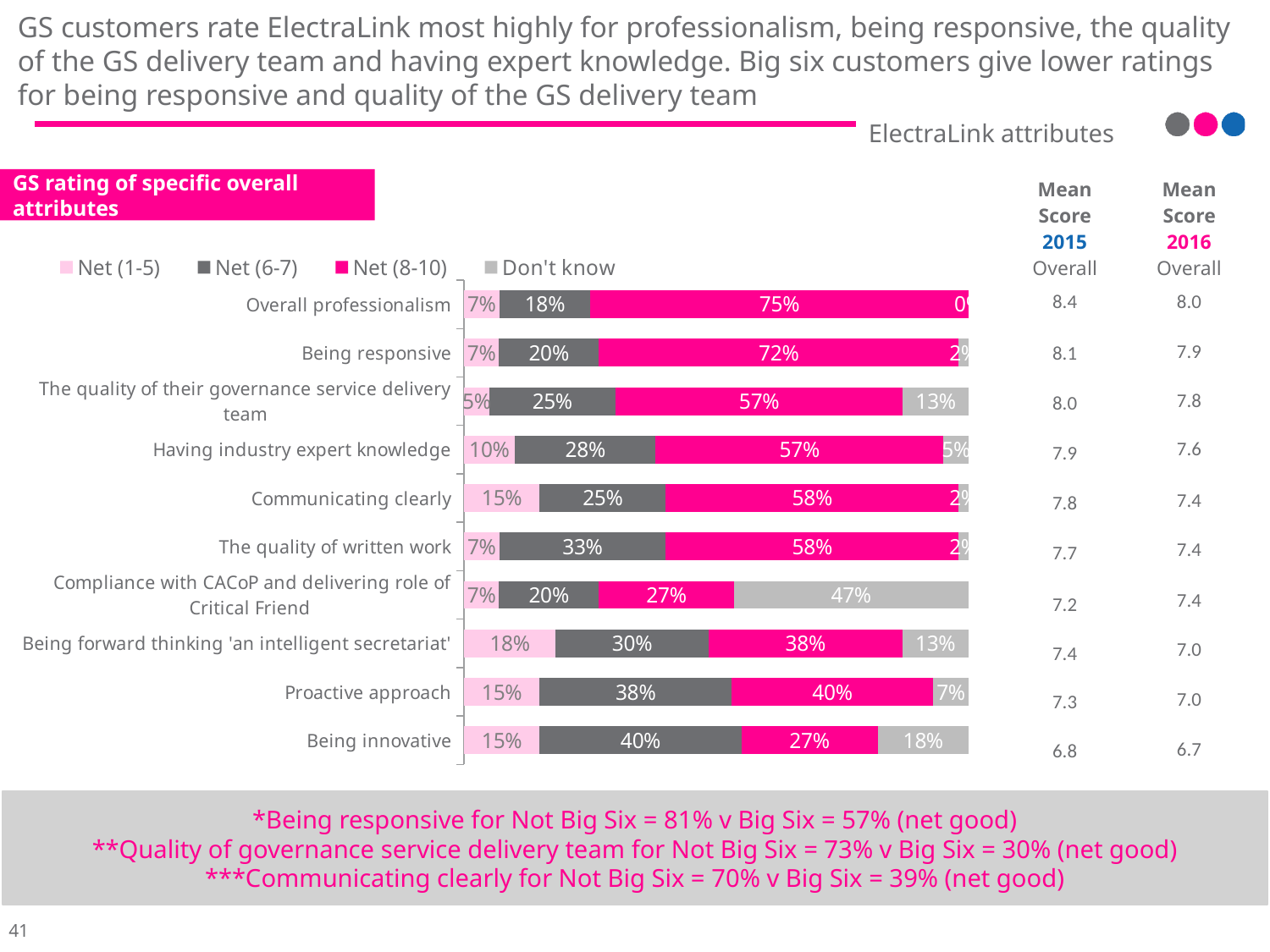
Which attribute has the highest Net (6-7) percentage? Being innovative What is the Net (1-5) percentage for Being forward thinking 'an intelligent secretariat'? 18% What type of chart is used to show the GS rating of specific overall attributes? Stacked bar chart What percentage of GS customers gave a Net (8-10) rating for Overall professionalism? 75% What is the Don't know percentage for Compliance with CACoP and delivering role of Critical Friend? 47% Which attribute has the lowest Net (6-7) percentage? Overall professionalism How many attributes are shown in the chart? 10 Which has a larger Net (8-10) percentage: Communicating clearly or Compliance with CACoP and delivering role of Critical Friend? Communicating clearly How many series does the chart legend list? 4 What is the difference in Net (8-10) percentage between Overall professionalism and Being innovative? 48 percentage points Which attribute has the highest Net (8-10) percentage? Overall professionalism What is the Don't know percentage for Being innovative? 18%